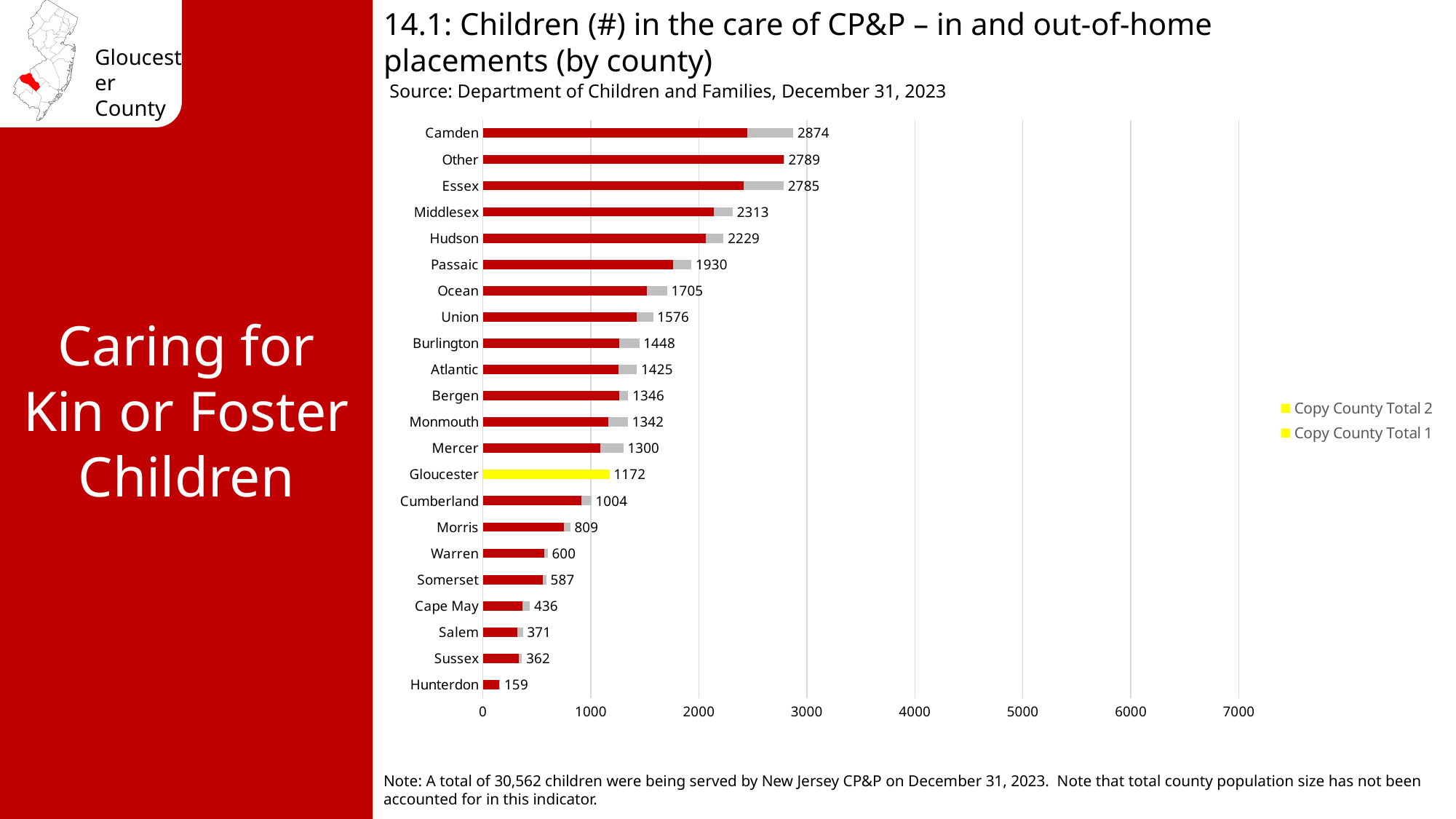
How many counties (categories) are shown on the chart? 22 Which county has the highest total number of children in the care of CP&P? Camden Which county has the lowest total number of children in the care of CP&P? Hunterdon How many series does the legend list? 2 What is the total value shown for Hunterdon? 159 Is the total for Middlesex greater or less than 2000? greater Which county's bar is highlighted in yellow? Gloucester What is the total number of children in the care of CP&P for Gloucester? 1172 Which has a larger total, Passaic or Ocean? Passaic What kind of chart is shown on the slide? Bar chart What is the difference between the totals for Camden and Gloucester? 1702 What is the total value shown for Camden? 2874